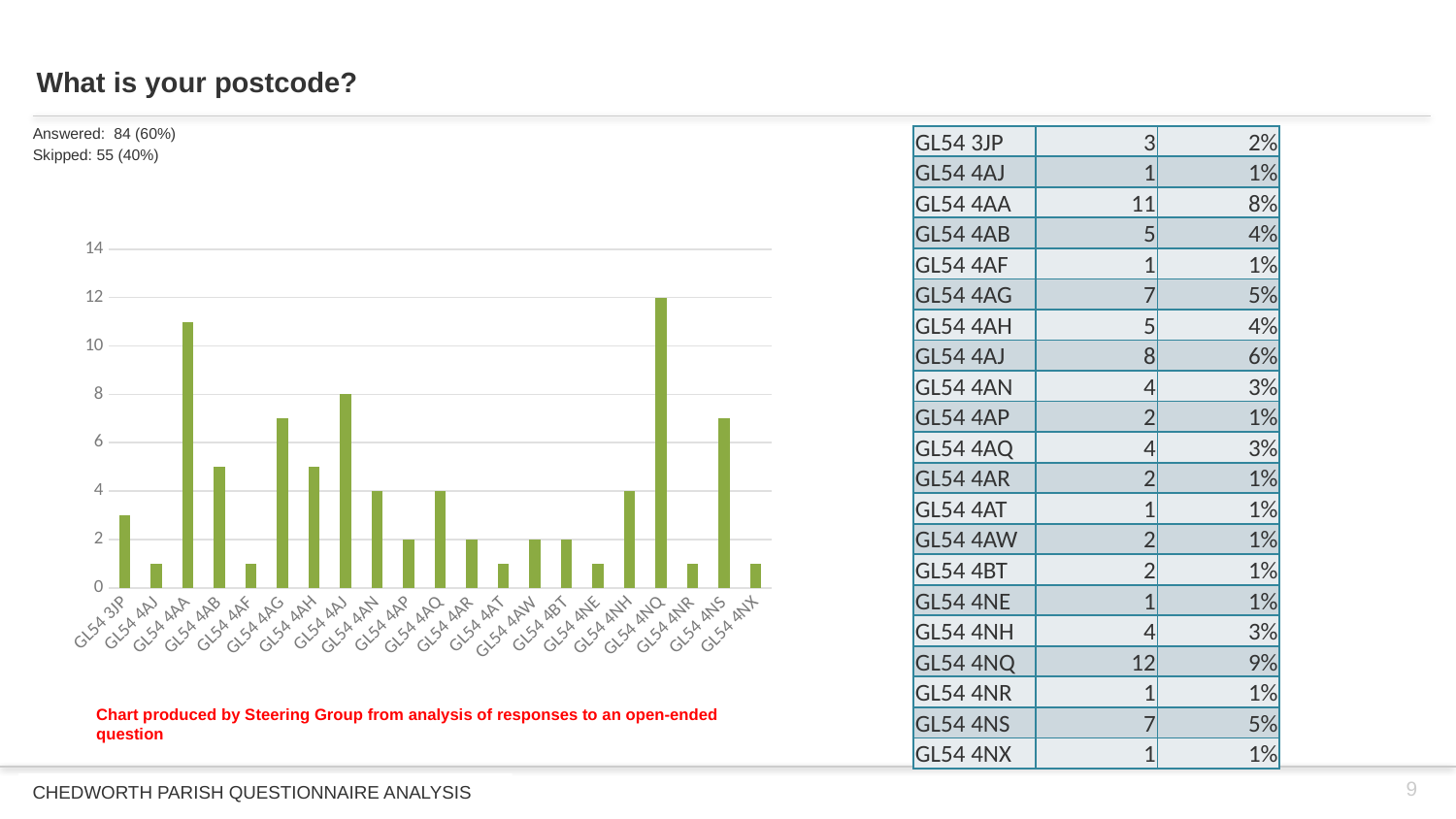
Which has more responses, GL54 4AA or GL54 4NS? GL54 4AA How many responses are recorded for GL54 4NS? 7 Is the value for GL54 4AN greater or less than 6? less What percentage share of responses does GL54 4NQ represent according to the table? 9% What kind of chart is shown on the slide? bar chart Which postcode has the highest number of responses? GL54 4NQ Is the value for GL54 4AG greater or less than 6? greater How many responses are recorded for GL54 4NQ? 12 How many postcode categories are plotted on the chart? 21 How many respondents answered the postcode question? 84 (60%) What is the difference in responses between GL54 4NQ and GL54 4AA? 1 How many responses are recorded for GL54 4AA? 11